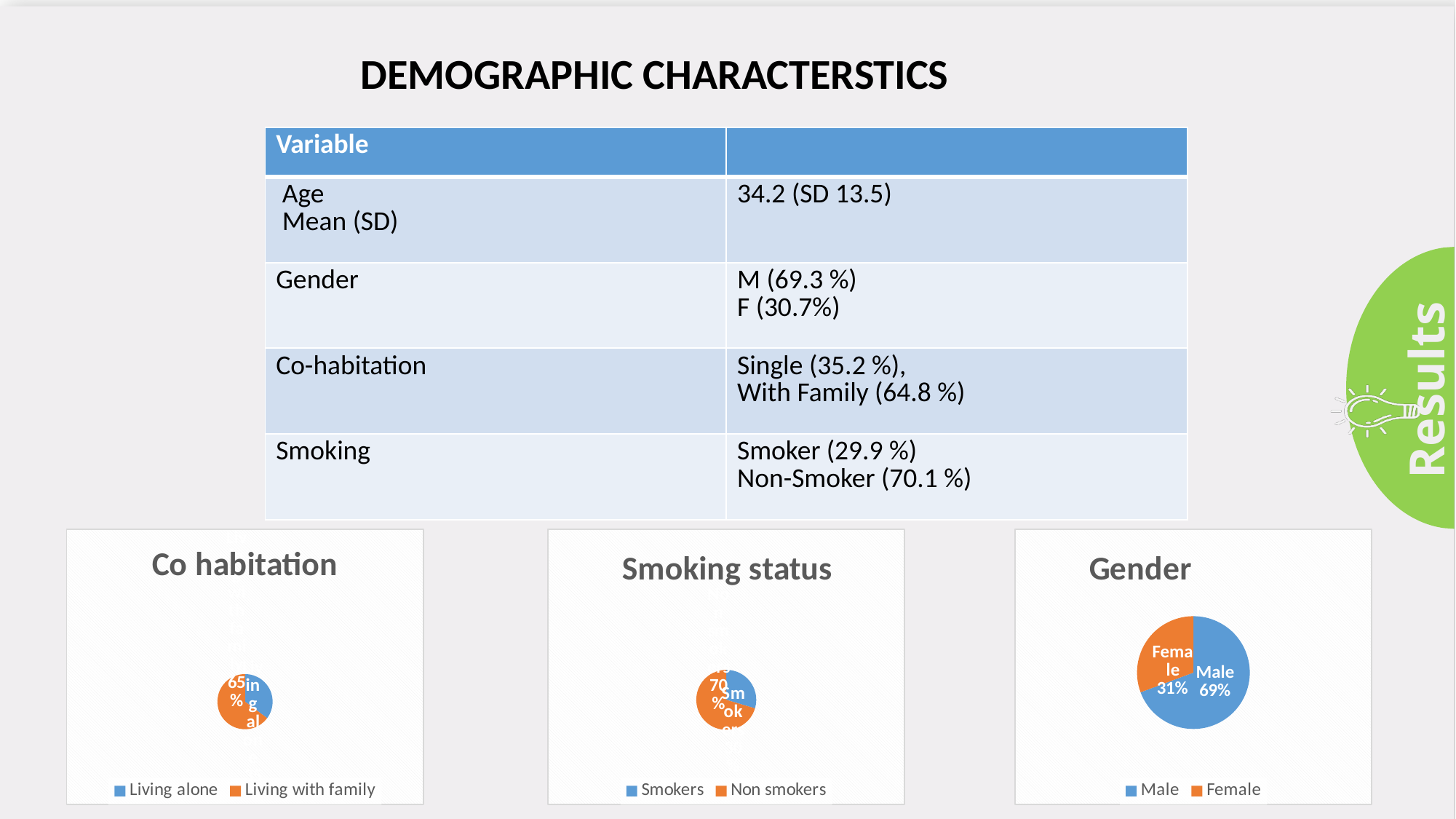
In the Gender chart, what share of the pie is Female? 31% What are the two legend entries of the Smoking status chart? Smokers, Non smokers How many entries does the legend of the Co habitation chart list? 2 In the Gender chart, which slice is larger, Male or Female? Male What kind of chart is the Gender chart? pie chart In the Co habitation chart, which slice is larger, Living alone or Living with family? Living with family How many slices does the Gender pie chart have? 2 In the Gender chart, what share of the pie is Male? 69% In the Gender chart, which colour represents Female? orange How many entries does the legend of the Gender chart list? 2 In the Smoking status chart, which slice is larger, Smokers or Non smokers? Non smokers In the Gender chart, what is the difference between the Male and Female shares? 38%